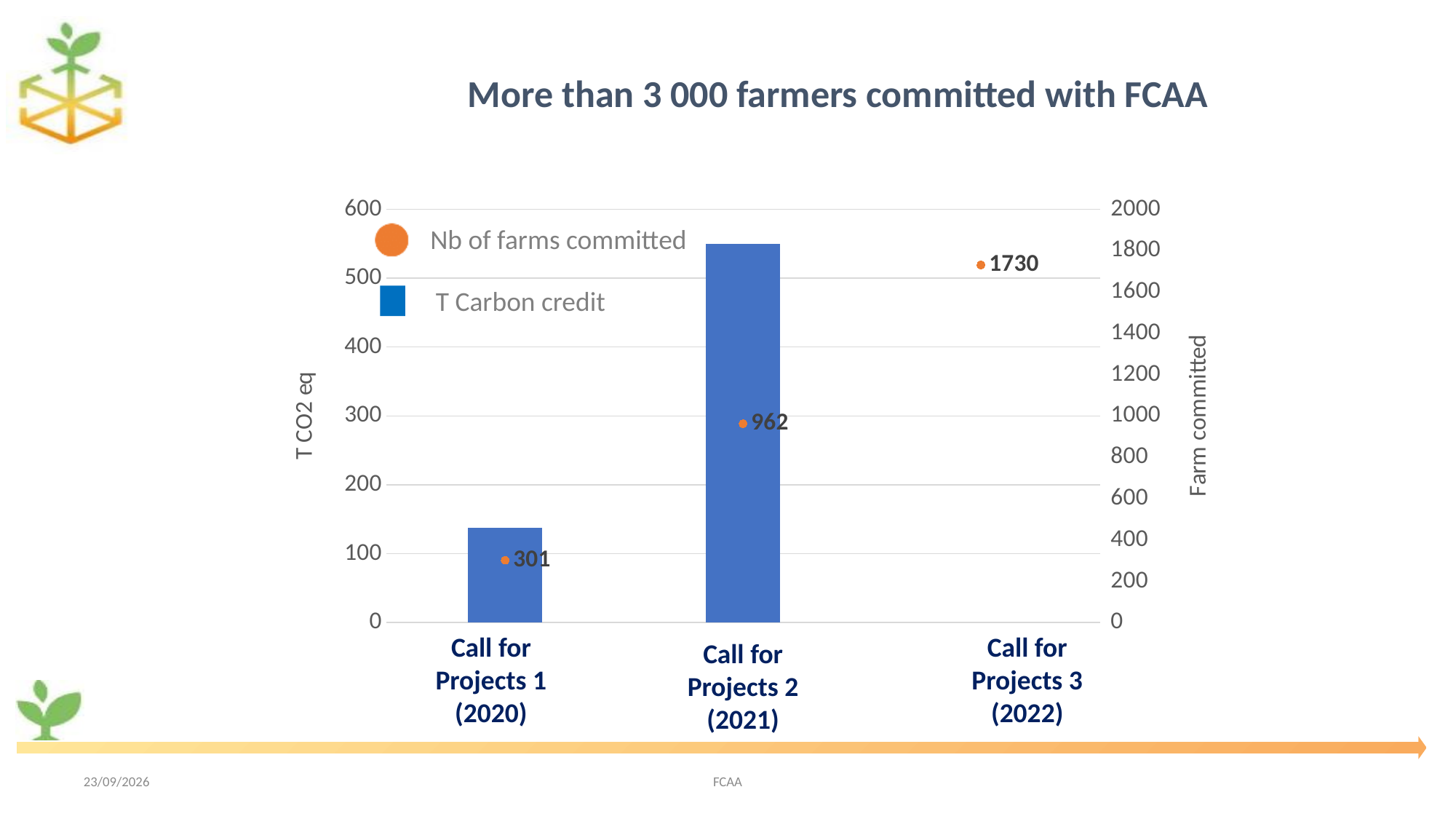
Is the T Carbon credit value for Call for Projects 2 (2021) greater or less than 500? greater Which call for projects has the highest number of farms committed? Call for Projects 3 (2022) What is the number of farms committed for Call for Projects 1 (2020)? 301 How many series does the legend list? 2 What is the number of farms committed for Call for Projects 3 (2022)? 1730 What is the number of farms committed for Call for Projects 2 (2021)? 962 Does the number of farms committed rise or fall from Call for Projects 1 to Call for Projects 3? rise Is the T Carbon credit value for Call for Projects 1 (2020) greater or less than 200? less Which has more farms committed, Call for Projects 1 (2020) or Call for Projects 2 (2021)? Call for Projects 2 (2021) What is the difference in the number of farms committed between Call for Projects 3 (2022) and Call for Projects 2 (2021)? 768 Which call for projects has the lowest number of farms committed? Call for Projects 1 (2020) How many calls for projects are shown on the x axis? 3